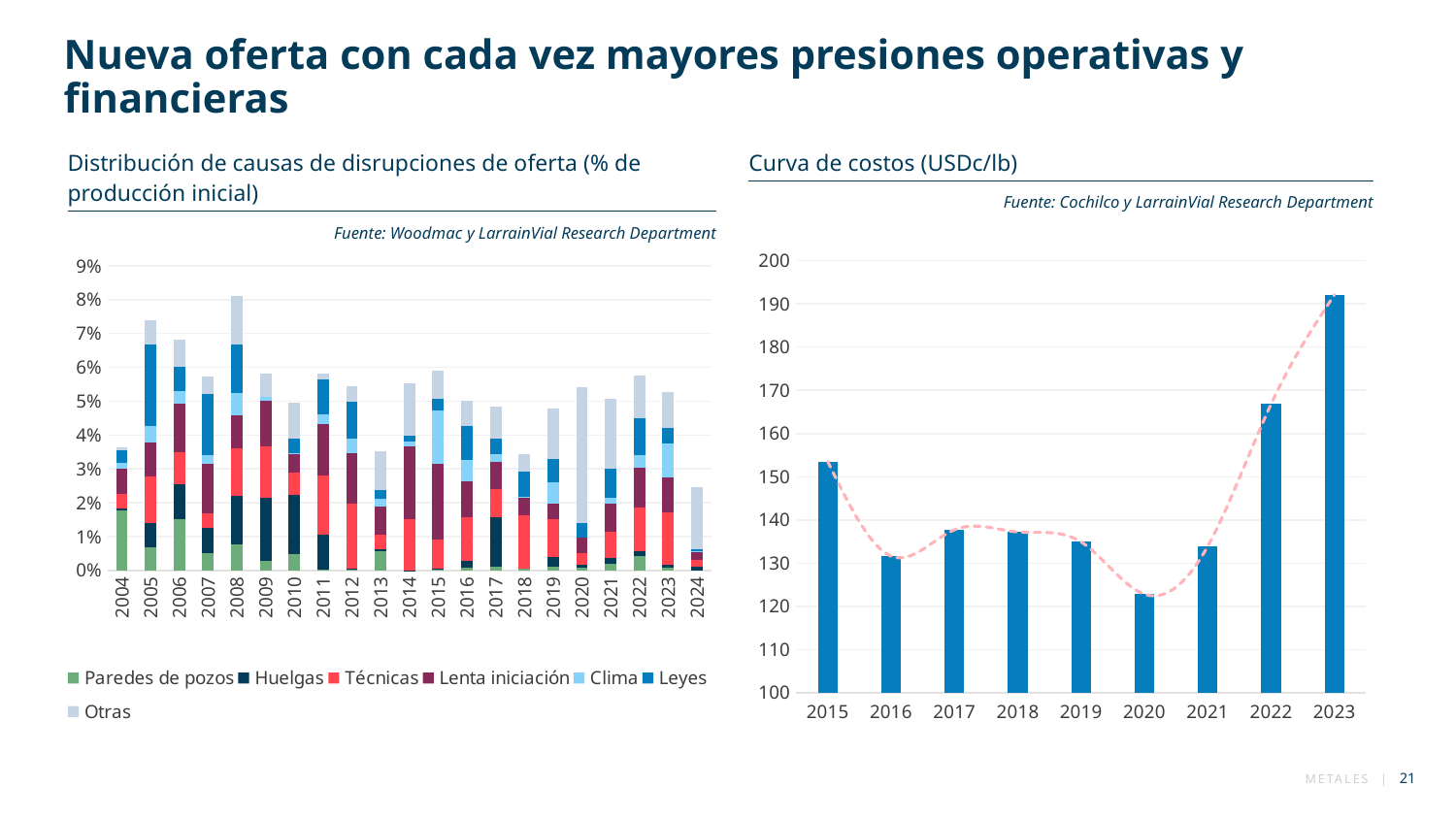
In the 'Curva de costos (USDc/lb)' chart, is the value for 2023 greater or less than 180? greater How many series does the legend of the 'Distribución de causas de disrupciones de oferta' chart list? 7 How many years are shown on the x axis of the 'Distribución de causas de disrupciones de oferta' chart? 21 In the 'Curva de costos (USDc/lb)' chart, do the values rise or fall from 2020 to 2023? rise How many years are shown on the x axis of the 'Curva de costos (USDc/lb)' chart? 9 In the 'Distribución de causas de disrupciones de oferta' chart, which year has the tallest stacked bar? 2008 In the 'Distribución de causas de disrupciones de oferta' chart, is the total for 2024 greater or less than 3%? less In the 'Curva de costos (USDc/lb)' chart, which year has the lowest value? 2020 In the 'Curva de costos (USDc/lb)' chart, which is larger, the value for 2015 or the value for 2022? 2022 What kind of chart is the 'Curva de costos (USDc/lb)' chart on the right? combination bar and line chart In the 'Curva de costos (USDc/lb)' chart, which year has the highest value? 2023 In the 'Curva de costos (USDc/lb)' chart, is the value for 2020 greater or less than 130? less